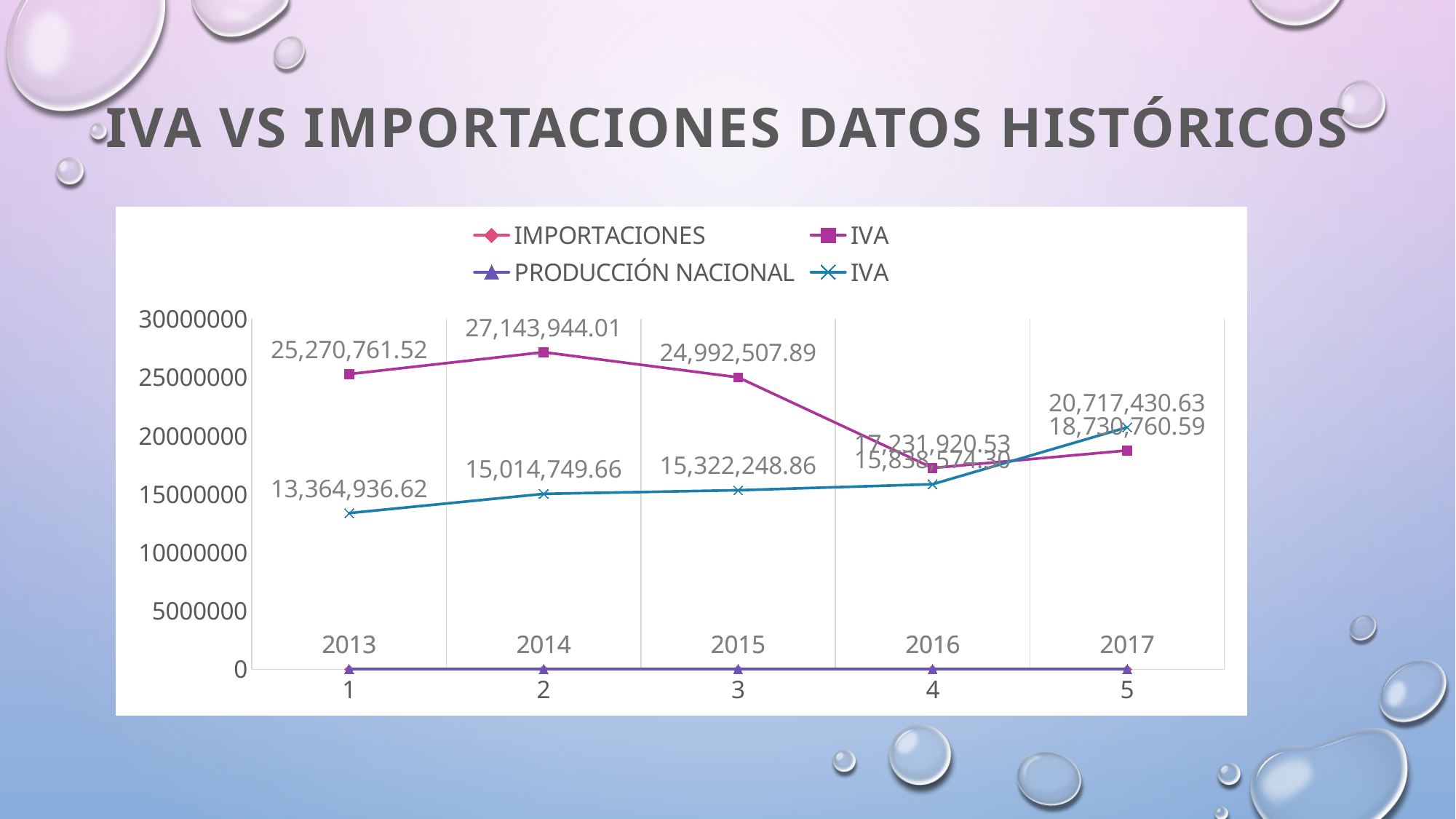
What is the value of the blue IVA line (x markers) for 2013? 13,364,936.62 Is the value of the magenta IVA line (square markers) for 2016 greater or less than 20000000? less In which year does the blue IVA line (x markers) have its lowest value? 2013 What kind of chart is shown on the slide? line chart What is the difference between the magenta IVA line's 2014 and 2013 values? 1,873,182.49 What is the value of the magenta IVA line (square markers) for 2014? 27,143,944.01 How many years are plotted along the x axis? 5 What is the value of the magenta IVA line (square markers) for 2015? 24,992,507.89 What is the value of the blue IVA line (x markers) for 2017? 20,717,430.63 How many series does the legend list? 4 In which year does the magenta IVA line (square markers) reach its highest value? 2014 In 2017, which is larger: the blue IVA line (x markers) or the magenta IVA line (square markers)? the blue IVA line (x markers)